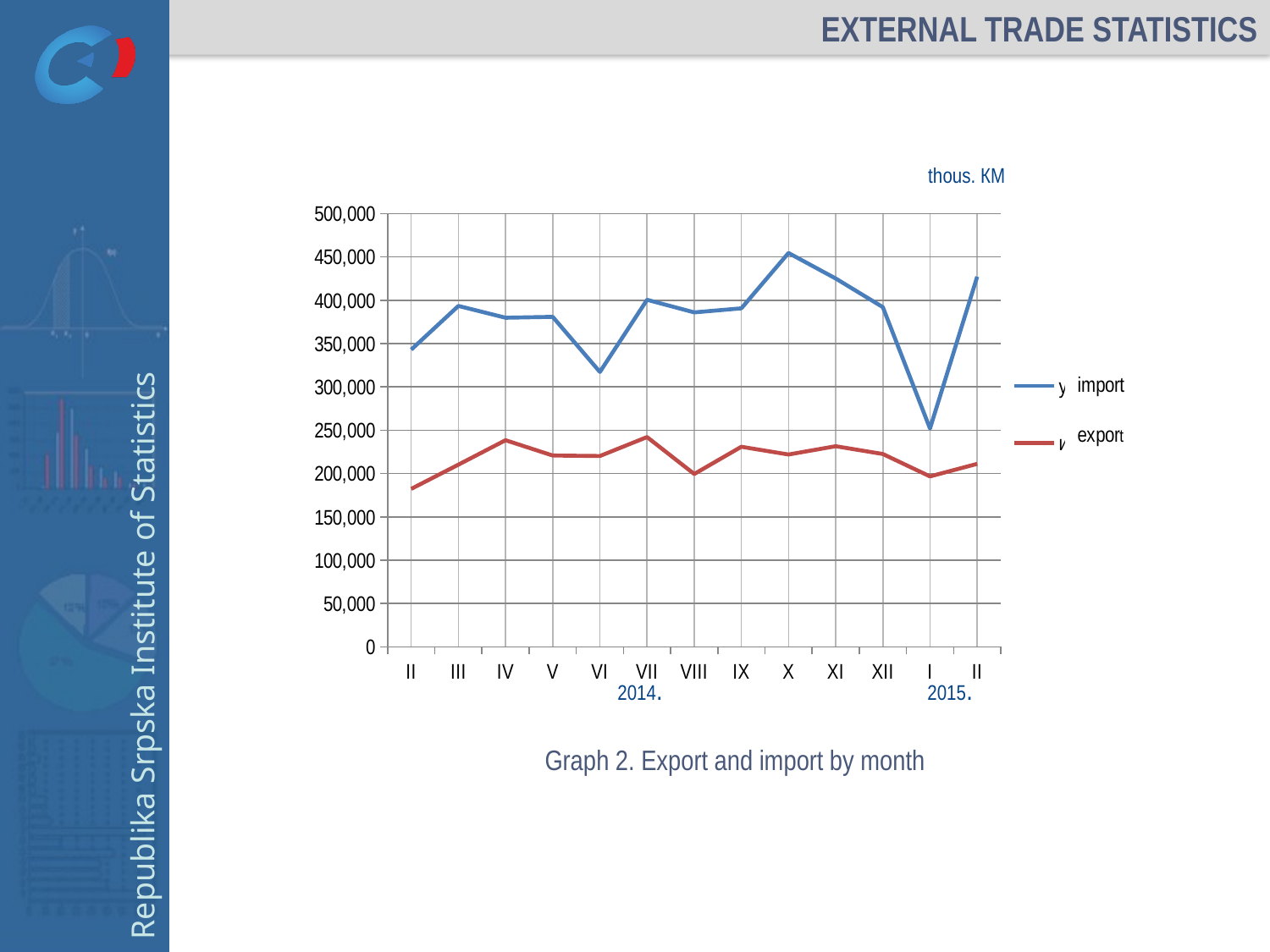
How many series does the legend list in Graph 2? 2 In which month is the import value lowest in Graph 2? I 2015 Is the import value for X 2014 greater or less than 400,000? greater Is the export value for II 2014 greater or less than 200,000? less How many monthly points are plotted for each series in Graph 2? 13 In which month is the export value lowest in Graph 2? II 2014 Which is larger in VII 2014, import or export? import In which month is the import value highest in Graph 2? X 2014 Is the import value for I 2015 greater or less than 300,000? less Does the import value rise or fall from XII 2014 to I 2015? fall What kind of chart is Graph 2. Export and import by month? line chart What unit is shown above the chart in Graph 2? thous. KM